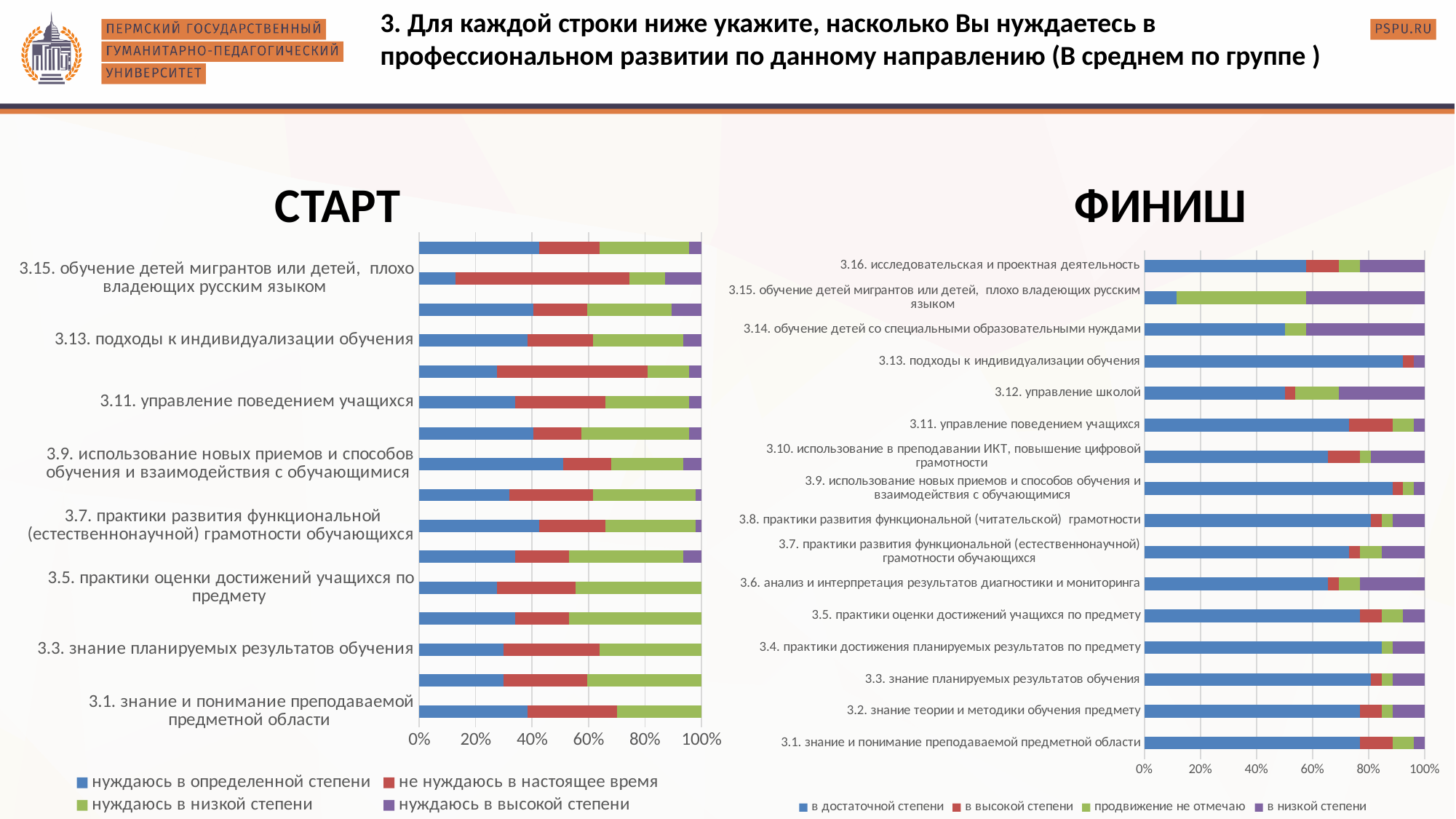
What is the title of the chart on the right side of the slide? ФИНИШ In the ФИНИШ chart on the right, which has the larger 'в достаточной степени' (blue) segment: 3.13 or 3.15? 3.13 In the ФИНИШ chart on the right, is the 'в достаточной степени' (blue) value for 3.15 greater or less than 20%? less How many series does the legend of the СТАРТ chart on the left list? 4 What kind of chart is the СТАРТ chart on the left? Stacked bar chart In the ФИНИШ chart on the right, is the 'в достаточной степени' (blue) value for 3.13 greater or less than 80%? greater In the ФИНИШ chart on the right, which category has the largest 'в достаточной степени' (blue) segment? 3.13. подходы к индивидуализации обучения In the ФИНИШ chart on the right, is the 'в достаточной степени' (blue) value for 3.16 greater or less than 80%? less How many series does the legend of the ФИНИШ chart on the right list? 4 How many categories are shown on the ФИНИШ chart on the right? 16 In the ФИНИШ chart on the right, which category has the smallest 'в достаточной степени' (blue) segment? 3.15. обучение детей мигрантов или детей, плохо владеющих русским языком